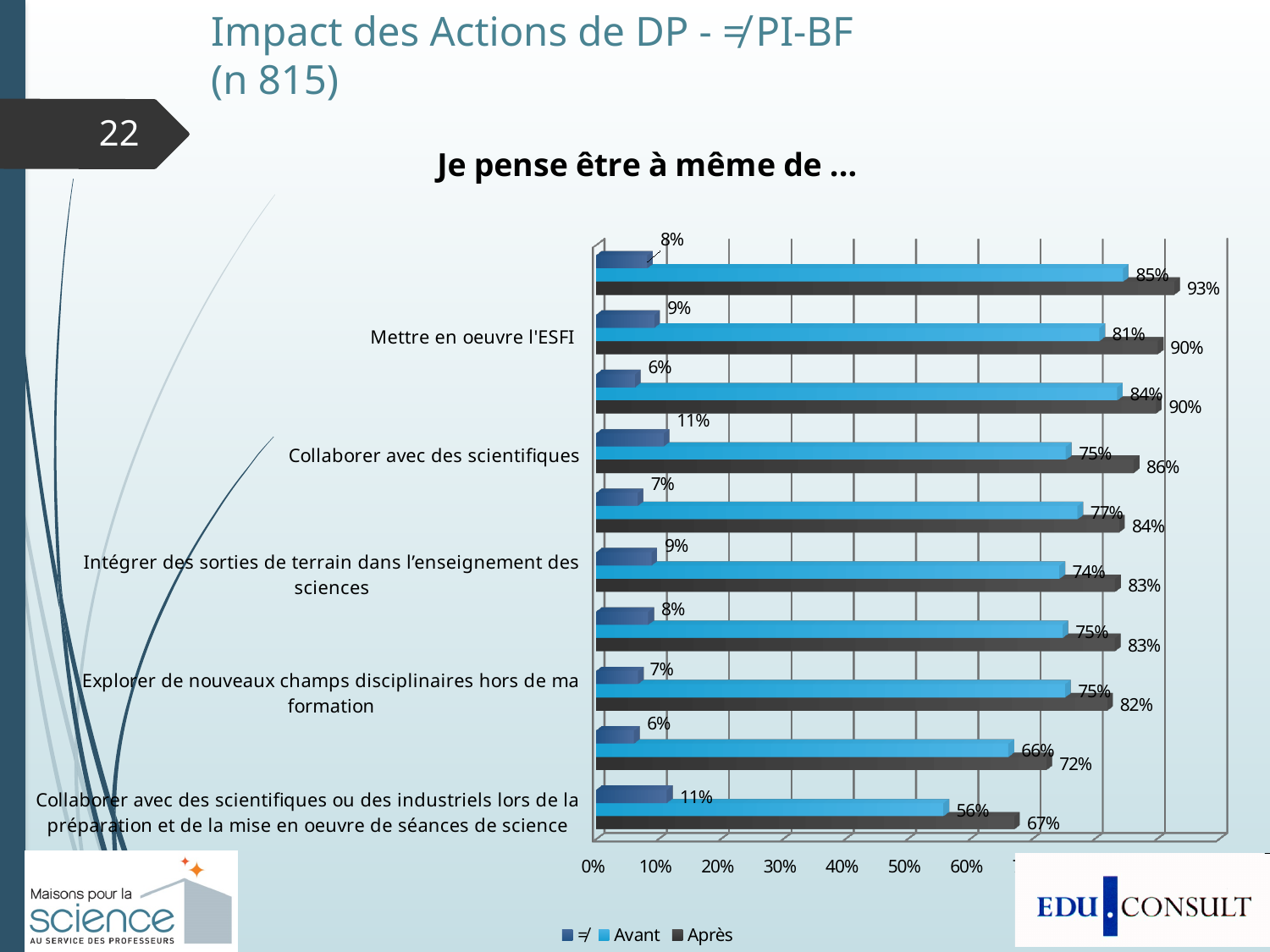
What is the 'Après' value for 'Intégrer des sorties de terrain dans l'enseignement des sciences'? 83% What is the title of the chart? Je pense être à même de ... What is the 'Après' value for 'Mettre en oeuvre l'ESFI'? 90% What is the 'Après' value for 'Collaborer avec des scientifiques ou des industriels lors de la préparation et de la mise en oeuvre de séances de science'? 67% What kind of chart is shown on the slide? bar chart What is the 'Avant' value for 'Collaborer avec des scientifiques'? 75% How many series does the chart legend list? 3 Which is larger for 'Explorer de nouveaux champs disciplinaires hors de ma formation': the 'Avant' value or the 'Après' value? Après What is the 'Avant' value for 'Mettre en oeuvre l'ESFI'? 81% What is the highest 'Après' value shown in the chart? 93% What is the difference between the 'Après' and 'Avant' values for 'Collaborer avec des scientifiques'? 11% What is the lowest 'Avant' value shown in the chart? 56%